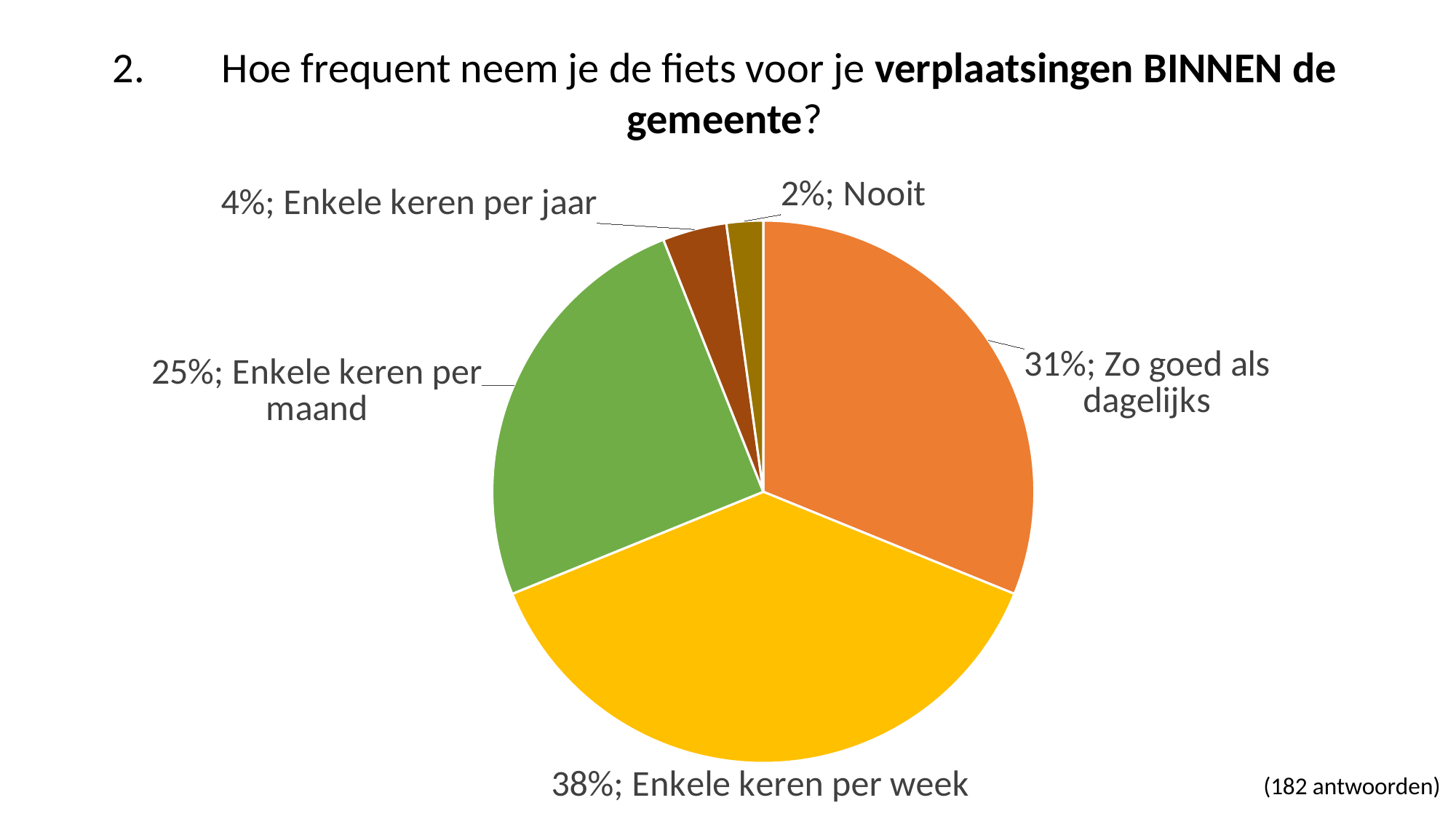
What kind of chart is shown on the slide? pie chart How many responses does the slide say the chart is based on? 182 antwoorden What share of respondents answered 'Nooit'? 2% How many categories are shown in the pie chart? 5 What share of respondents answered 'Enkele keren per week'? 38% Which is larger: the share for 'Enkele keren per maand' or the share for 'Enkele keren per jaar'? Enkele keren per maand What share of respondents answered 'Zo goed als dagelijks'? 31% What colour is the slice for 'Enkele keren per week'? yellow Which category has the smallest slice of the pie? Nooit Which category has the largest slice of the pie? Enkele keren per week What is the difference in percentage points between 'Enkele keren per week' and 'Zo goed als dagelijks'? 7